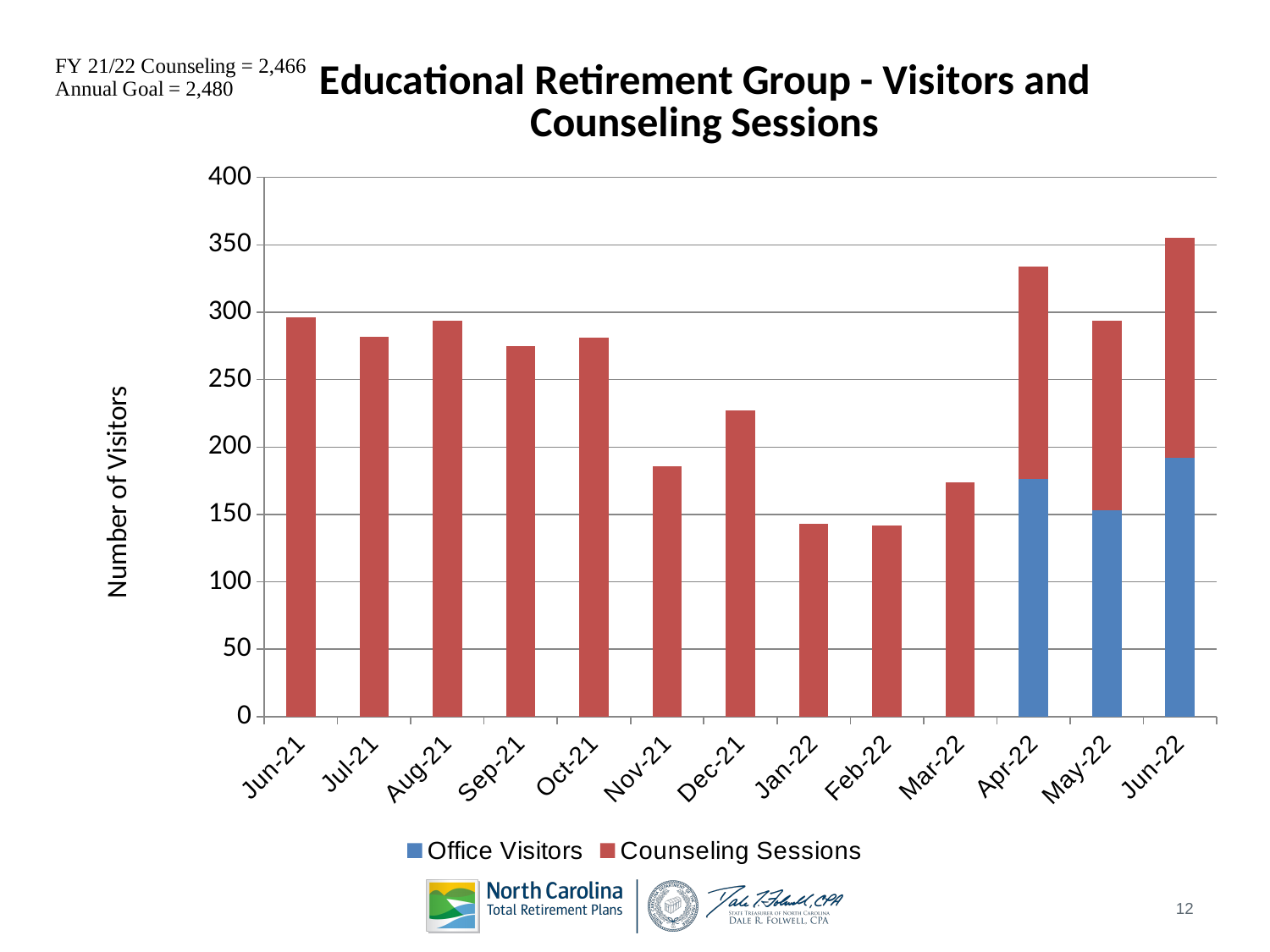
Is the value for Dec-21 greater or less than 200? greater Which month has the tallest bar in the chart? Jun-22 Is the value for Jun-21 greater or less than 250? greater How many months are shown along the x axis of the chart? 13 How many series does the chart legend list? 2 Which bar is taller, Aug-21 or Sep-21? Aug-21 What is the label on the vertical axis of the chart? Number of Visitors What type of chart is shown on the slide? bar chart Do the bar values generally rise or fall from Jun-21 to Feb-22? fall Which series is shown in blue in the chart legend? Office Visitors Is the total bar height for Apr-22 greater or less than 300? greater